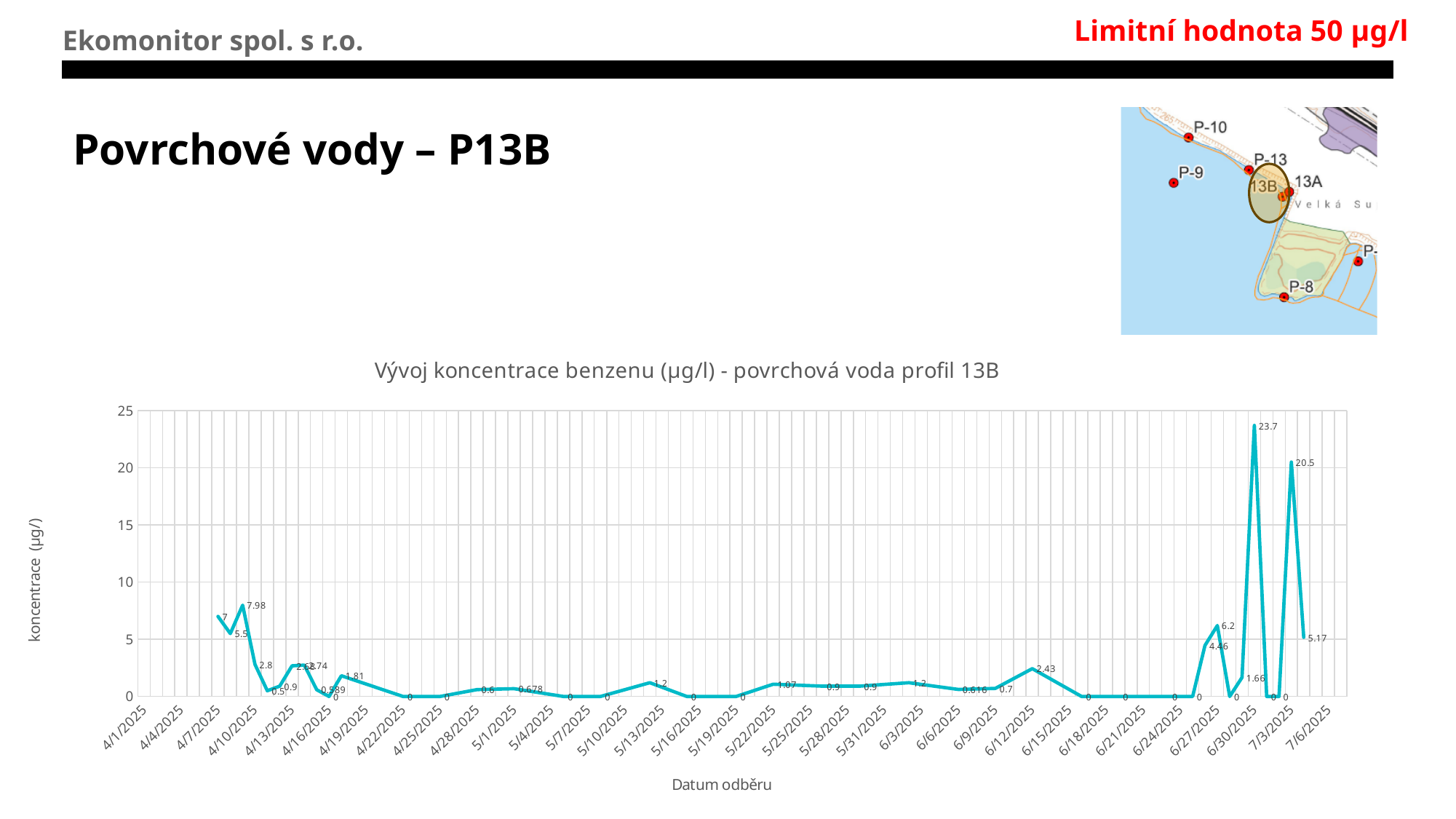
What is the value of the last data point plotted on the chart? 5.17 What is the difference between the late-June values 6.2 and 4.46? 1.74 What is the highest value plotted on the chart? 23.7 Which is larger: the peak value of 7.98 in early April or the peak value of 6.2 in late June? 7.98 What is the value of the second-highest peak on the chart, in early July? 20.5 What is the title of the chart? Vývoj koncentrace benzenu (µg/l) - povrchová voda profil 13B How many data series are plotted on the chart? 1 What is the difference between the two highest peaks on the chart (23.7 and 20.5)? 3.2 What is the label of the vertical axis of the chart? koncentrace (µg/l) Is the highest value on the chart greater or less than 20? greater What is the value of the first data point plotted on the chart? 7 What kind of chart is shown on the slide? line chart